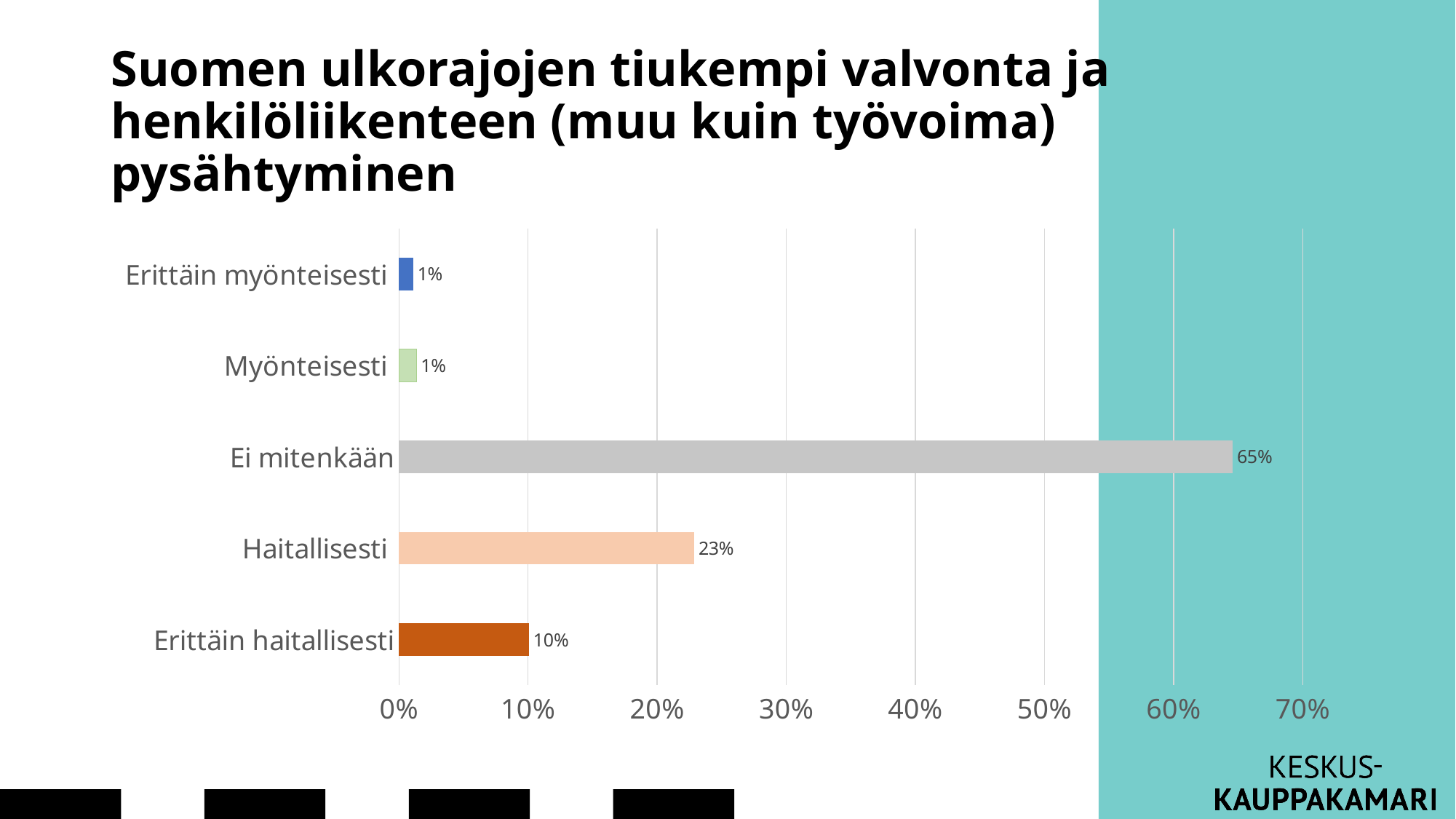
Which is larger, the value for Haitallisesti or the value for Erittäin haitallisesti? Haitallisesti How many categories are shown in the chart? 5 What is the value for Ei mitenkään? 65% What is the title of the slide? Suomen ulkorajojen tiukempi valvonta ja henkilöliikenteen (muu kuin työvoima) pysähtyminen Which category has the highest value? Ei mitenkään What is the difference between the values for Ei mitenkään and Haitallisesti? 42% What is the value for Myönteisesti? 1% Is the value for Ei mitenkään greater or less than 60%? greater What is the difference between the values for Haitallisesti and Erittäin haitallisesti? 13% What is the value for Erittäin haitallisesti? 10% What kind of chart is shown on the slide? bar chart What is the value for Haitallisesti? 23%